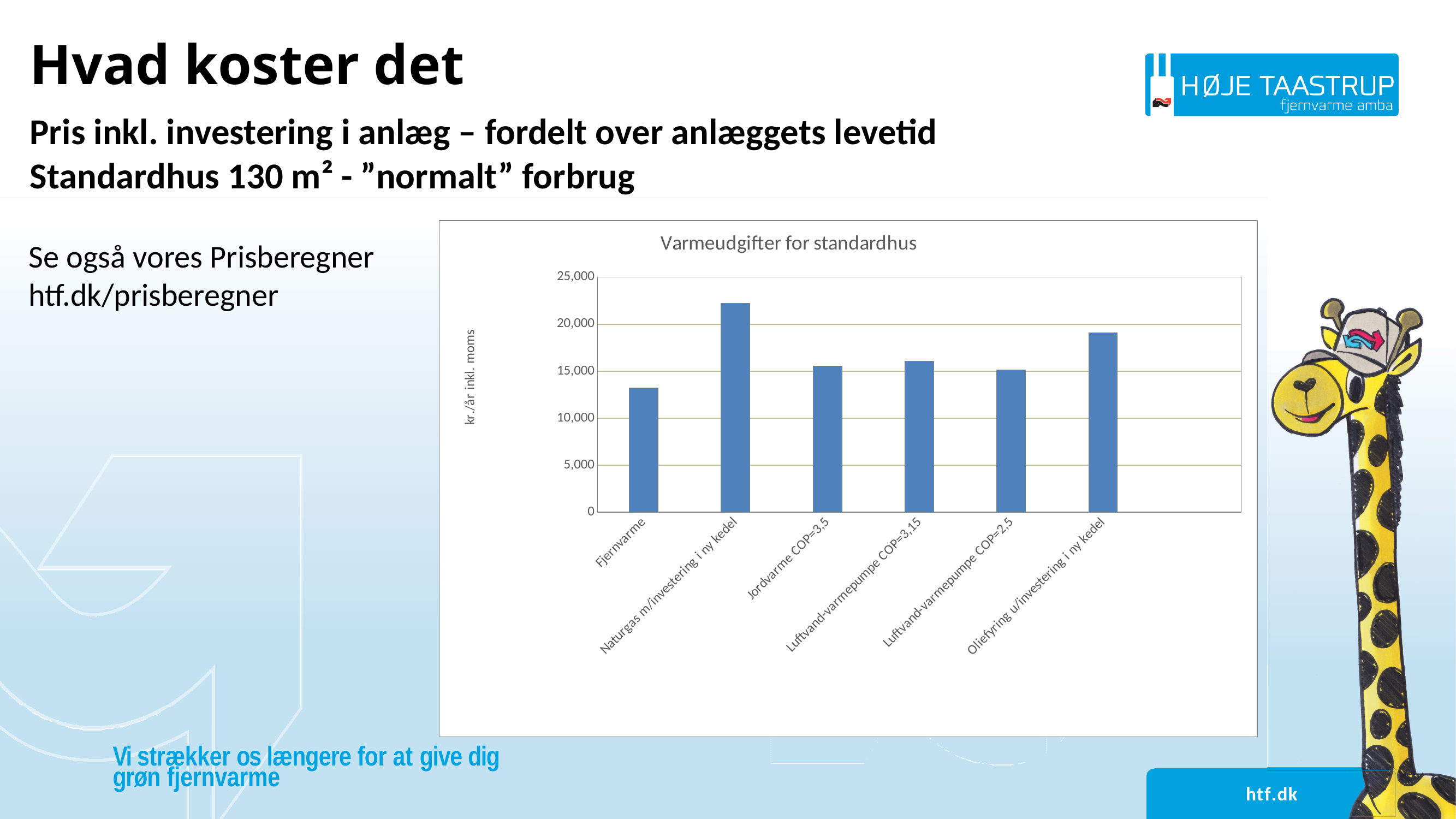
Is the value for Luftvand-varmepumpe COP=3,15 greater or less than 15,000? greater What kind of chart is shown on the slide? bar chart What is the title of the chart? Varmeudgifter for standardhus Which category has the lowest value in the chart? Fjernvarme What is the label on the vertical axis of the chart? kr./år inkl. moms Is the value for Naturgas m/investering i ny kedel greater or less than 20,000? greater Which is larger, the value for Fjernvarme or the value for Jordvarme COP=3,5? Jordvarme COP=3,5 Which is larger, the value for Naturgas m/investering i ny kedel or the value for Oliefyring u/investering i ny kedel? Naturgas m/investering i ny kedel Is the value for Oliefyring u/investering i ny kedel greater or less than 20,000? less How many categories (bars) are shown in the chart? 6 Which category has the highest value in the chart? Naturgas m/investering i ny kedel